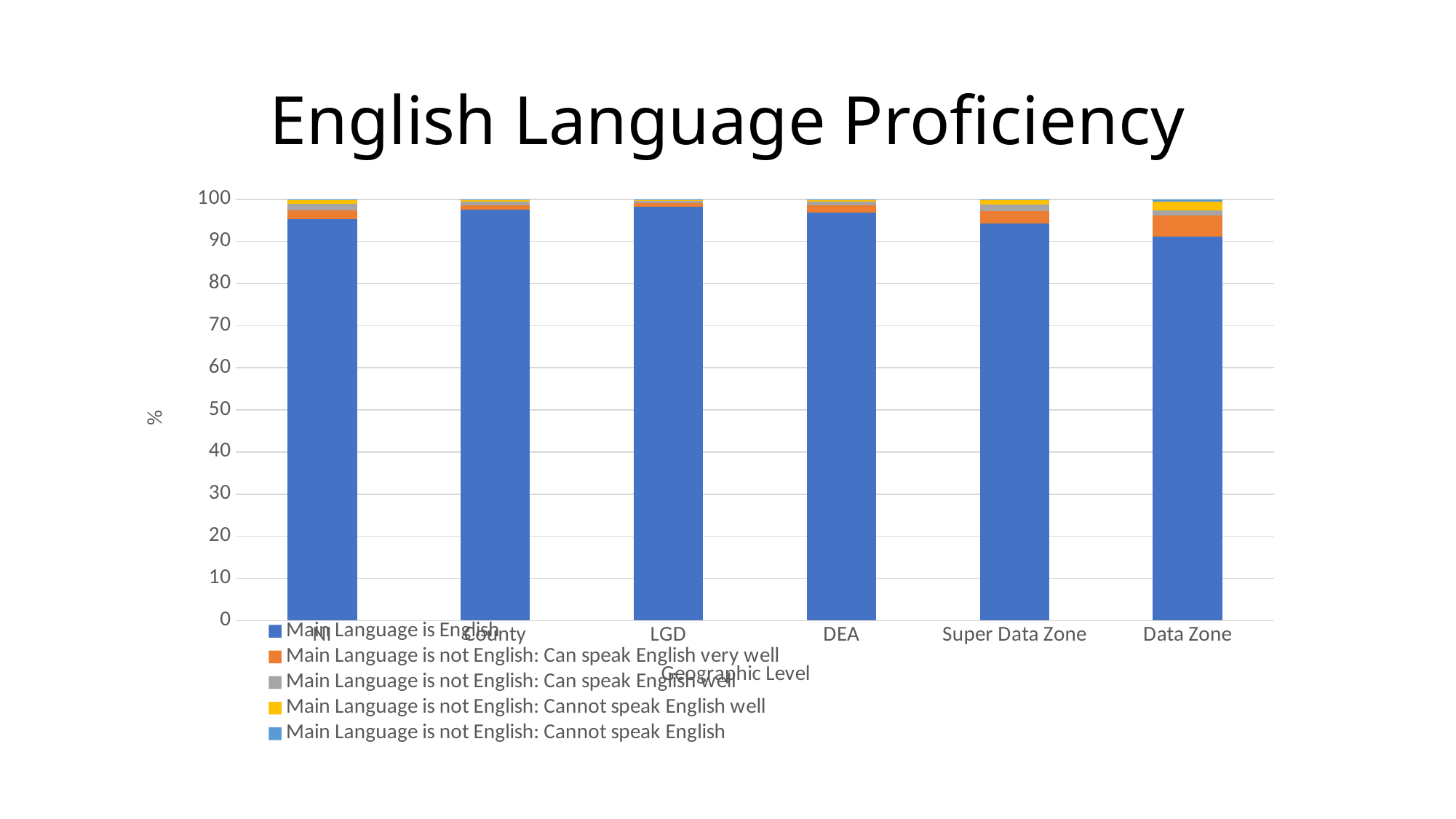
Which has a larger 'Main Language is English' share, NI or Data Zone? NI Is the 'Main Language is English' value for Data Zone greater or less than 80? greater What type of chart is shown on the slide? Stacked bar chart How many series does the legend list? 5 Which has a larger 'Main Language is not English: Can speak English very well' share, County or Data Zone? Data Zone Which has a larger 'Main Language is English' share, Super Data Zone or Data Zone? Super Data Zone Which geographic level has the smallest share for 'Main Language is English'? Data Zone Is the 'Main Language is English' value for LGD greater or less than 90? greater Is the 'Main Language is English' value for NI greater or less than 90? greater What is the title of the chart? English Language Proficiency How many geographic levels are shown on the x axis? 6 What is the x-axis title of the chart? Geographic Level